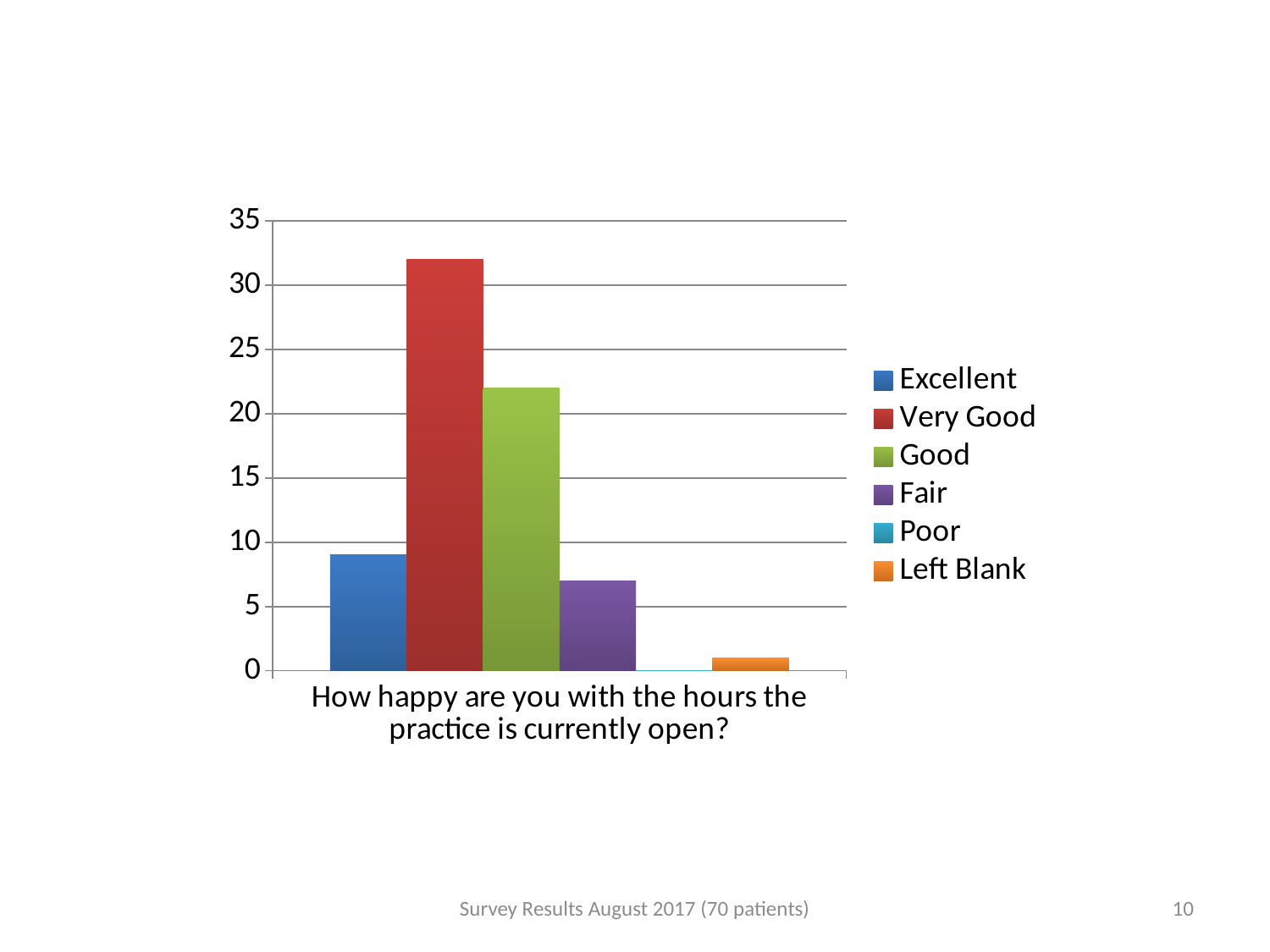
Is the value for Fair greater or less than 5? greater Which is larger, the value for Good or the value for Excellent? Good How many series does the legend list? 6 Is the value for Excellent greater or less than 10? less What question is shown as the category label beneath the bars? How happy are you with the hours the practice is currently open? Is the value for Very Good greater or less than 30? greater What kind of chart is shown on the slide? bar chart Which response category has the lowest bar? Poor Which is larger, the value for Fair or the value for Left Blank? Fair Which response category has the highest bar? Very Good